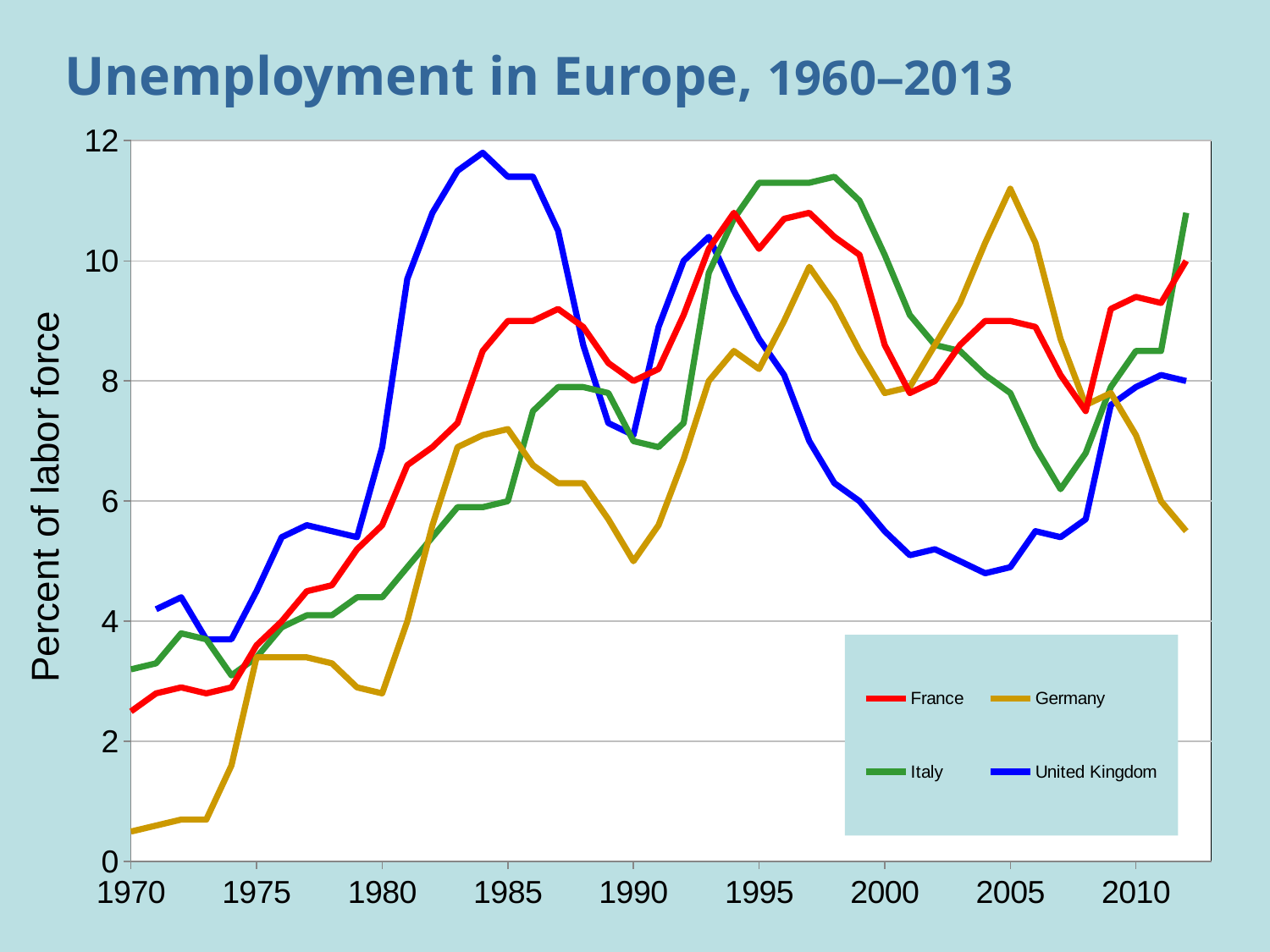
Which country has the lowest unemployment rate in 1970? Germany Which country has the highest unemployment rate in 2005? Germany What is the title of the chart? Unemployment in Europe, 1960–2013 What kind of chart is shown on the slide? line chart What is the label on the vertical axis? Percent of labor force Which country has the highest unemployment rate in 1984? United Kingdom Which country has the lowest unemployment rate in 2005? United Kingdom Is the value for Germany in 1970 greater or less than 2? less Does the unemployment rate for Germany rise or fall between 2005 and 2012? fall In 2012, which is larger, the value for Italy or the value for the United Kingdom? Italy How many series does the legend list? 4 Is the value for the United Kingdom in 1984 greater or less than 10? greater